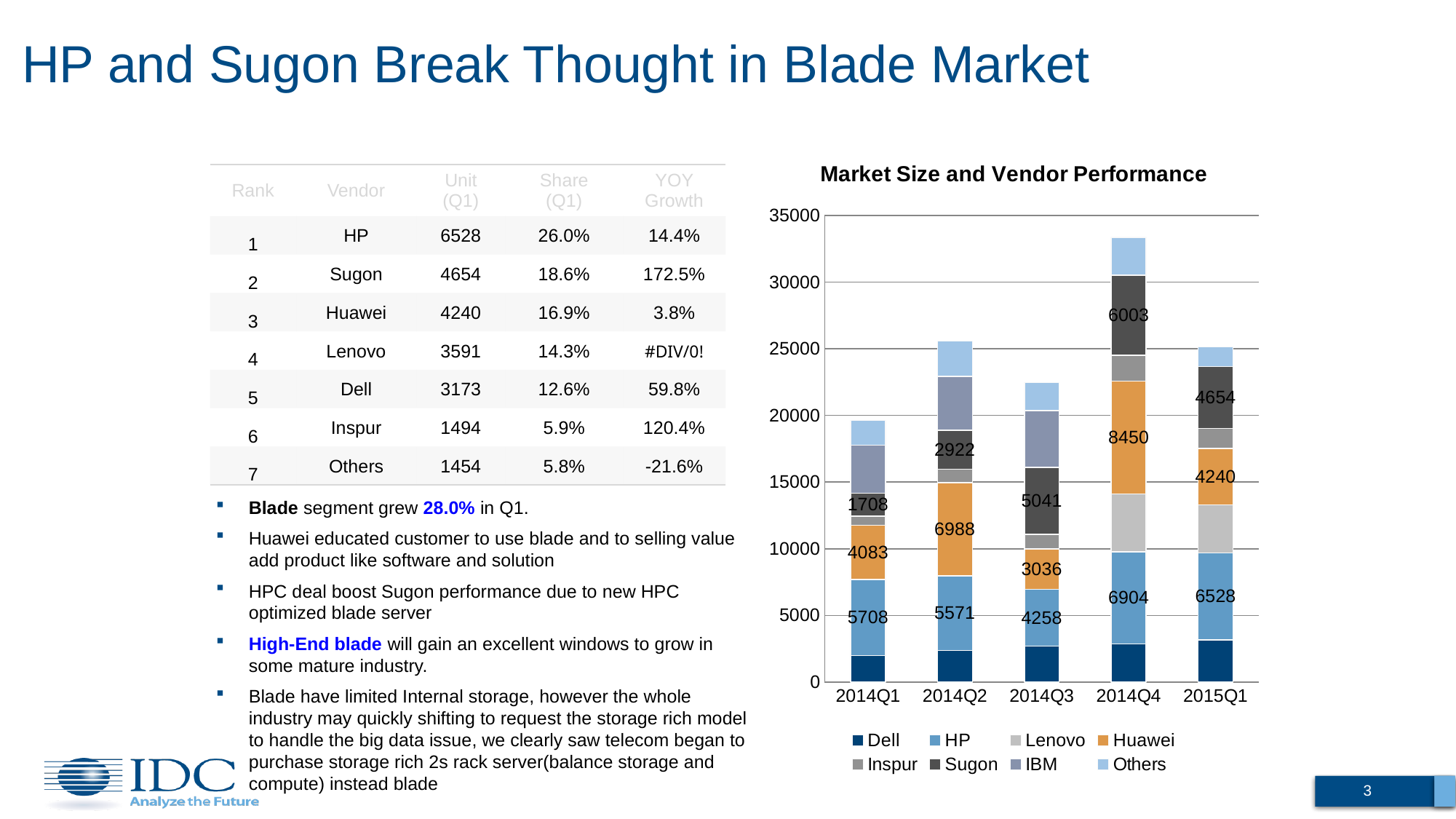
Which is larger, the HP value in 2014Q1 or in 2014Q2? 2014Q1 How many quarters are shown on the x axis of the chart? 5 What is the value for Huawei in 2014Q2? 6988 In which quarter is the HP value highest? 2014Q4 In which quarter is the Huawei value lowest? 2014Q3 What kind of chart is shown on the slide? Stacked bar chart What is the value for HP in 2014Q4? 6904 Is the total height of the 2014Q4 stacked bar greater or less than 30000? greater What is the value for Sugon in 2015Q1? 4654 How many series does the chart's legend list? 8 Do the Sugon values rise or fall from 2014Q1 to 2014Q4? rise What is the difference between the Sugon values in 2014Q4 and 2014Q3? 962